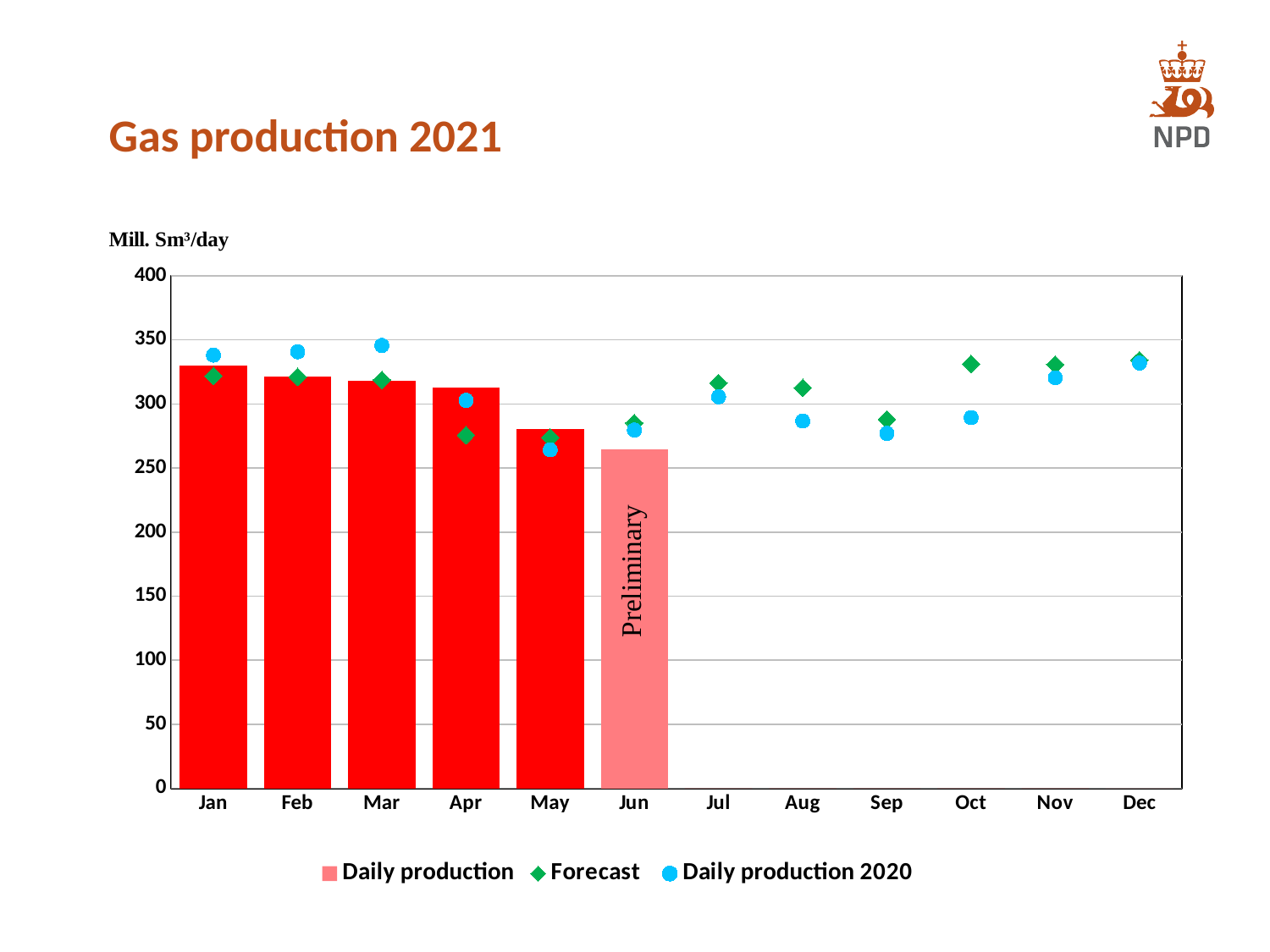
What kind of chart is shown on the slide? Bar chart (with point markers) How many series does the legend list? 3 Is the Daily production value for Jun greater or less than 300? less Is the Daily production value for Jan greater or less than 300? greater For Aug, which is larger: the Forecast value or the Daily production 2020 value? Forecast How many months have a Daily production bar plotted? 6 Do the Daily production bars rise or fall from Jan to Jun? Fall Which month has the lowest Daily production bar? Jun Is the Forecast value for Oct greater or less than 300? greater Which month has the highest Daily production bar? Jan What is the title of the chart? Gas production 2021 How many months are shown on the x axis? 12